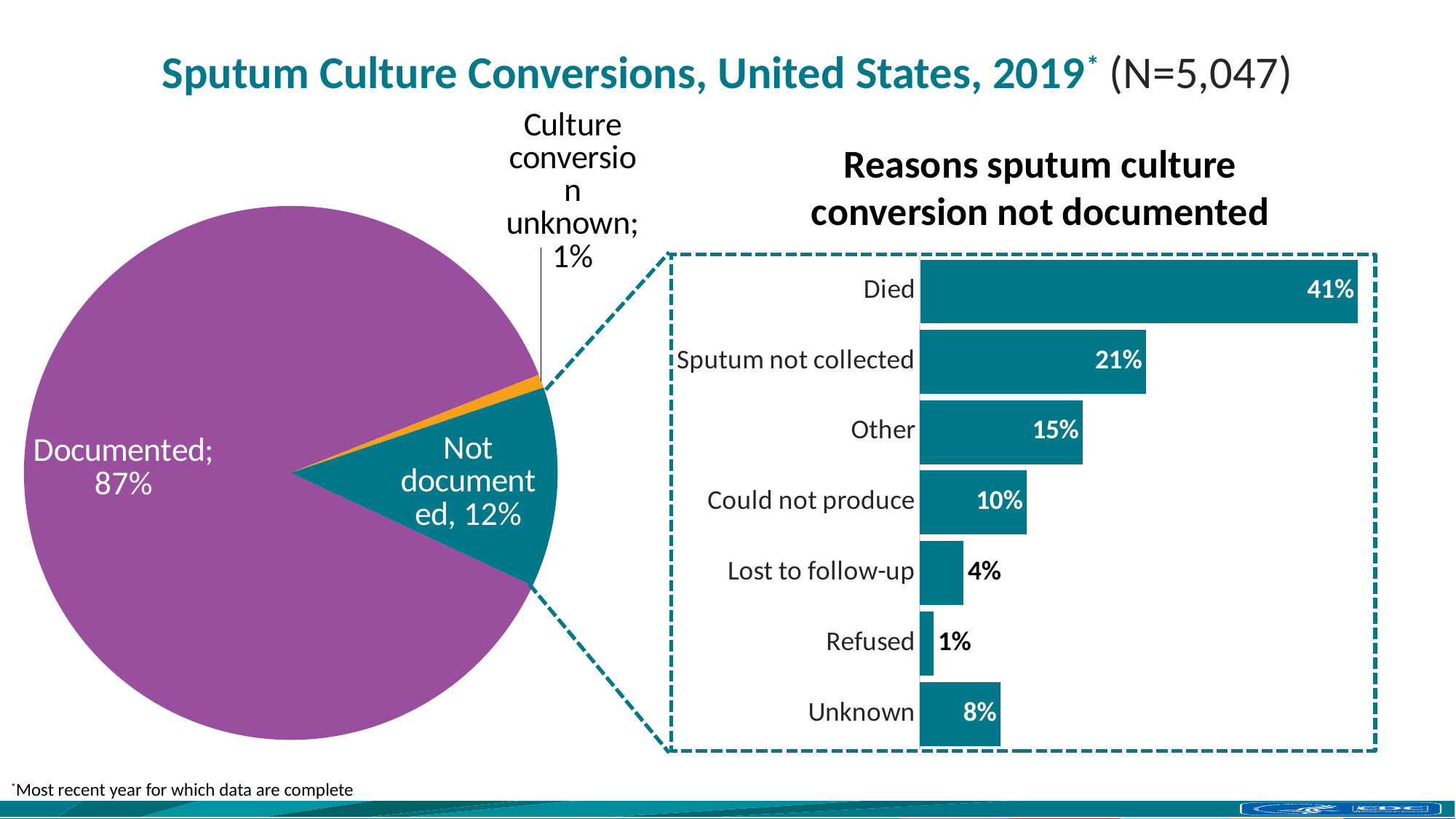
In the 'Reasons sputum culture conversion not documented' chart, which is larger: Other or Unknown? Other What type of chart is the 'Reasons sputum culture conversion not documented' chart? Bar chart In the pie chart, what share is Culture conversion unknown? 1% In the 'Reasons sputum culture conversion not documented' chart, which reason has the highest value? Died In the 'Reasons sputum culture conversion not documented' chart, what is the difference between Died and Sputum not collected? 20% How many reasons are listed in the 'Reasons sputum culture conversion not documented' chart? 7 In the 'Reasons sputum culture conversion not documented' chart, which reason has the lowest value? Refused How many slices does the pie chart have? 3 In the 'Reasons sputum culture conversion not documented' chart, what is the value for Died? 41% In the 'Reasons sputum culture conversion not documented' chart, what is the value for Sputum not collected? 21% In the pie chart, what share of sputum culture conversions is Documented? 87% In the pie chart, what share is Not documented? 12%